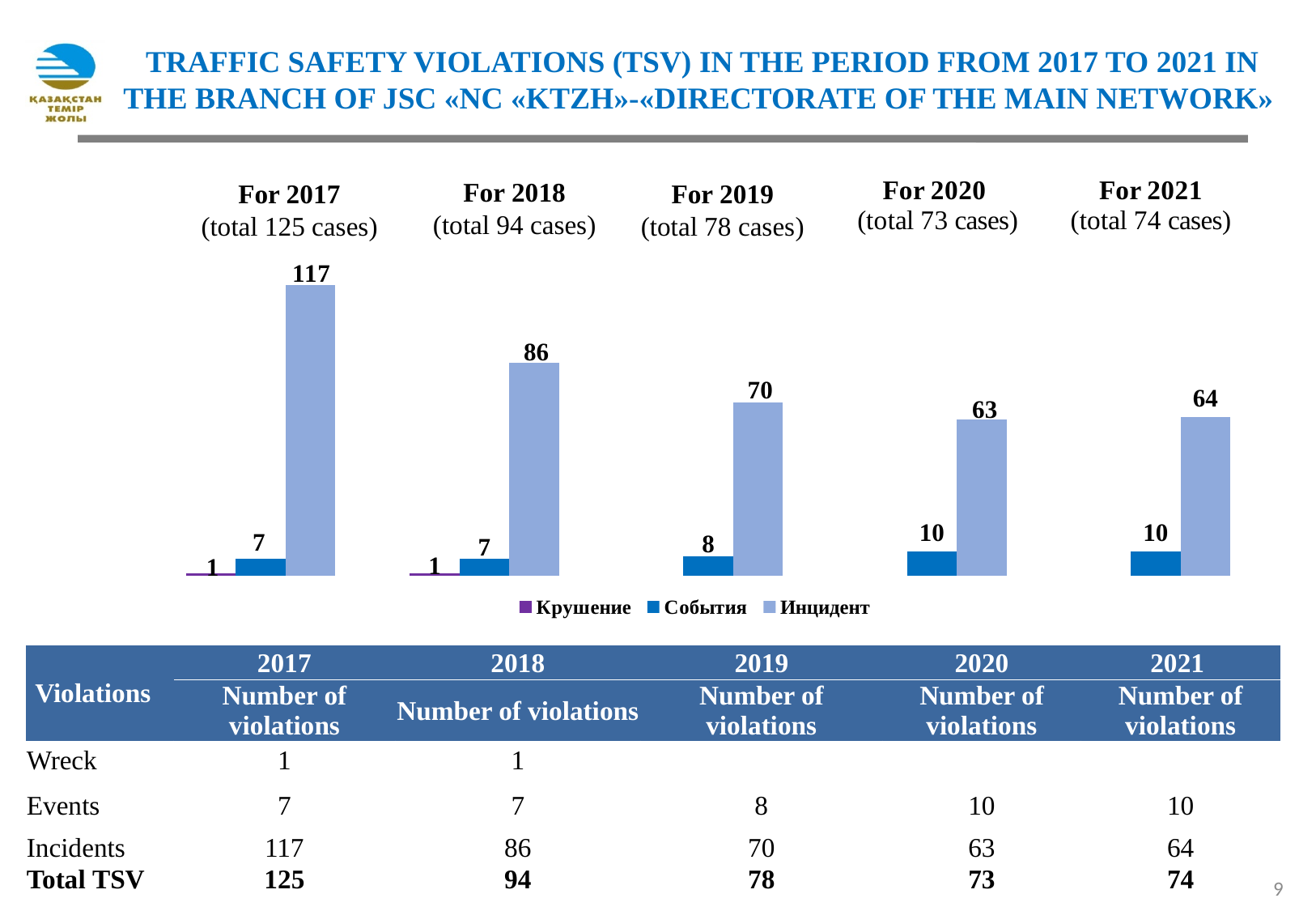
What is the total number of cases shown for 2021? 74 Which is larger, the События value for 2018 or for 2020? 2020 What is the difference between the Инцидент values for 2017 and 2018? 31 Does the Инцидент value fall or rise from 2017 to 2020? fall What is the value of the Крушение bar for 2018? 1 What is the value of the События bar for 2019? 8 What is the value of the Инцидент bar for 2017? 117 In which year is the Инцидент bar the lowest? 2020 How many series does the chart legend list? 3 What type of chart is shown on the slide? bar chart How many year groups are plotted in the chart? 5 In which year is the Инцидент bar the highest? 2017